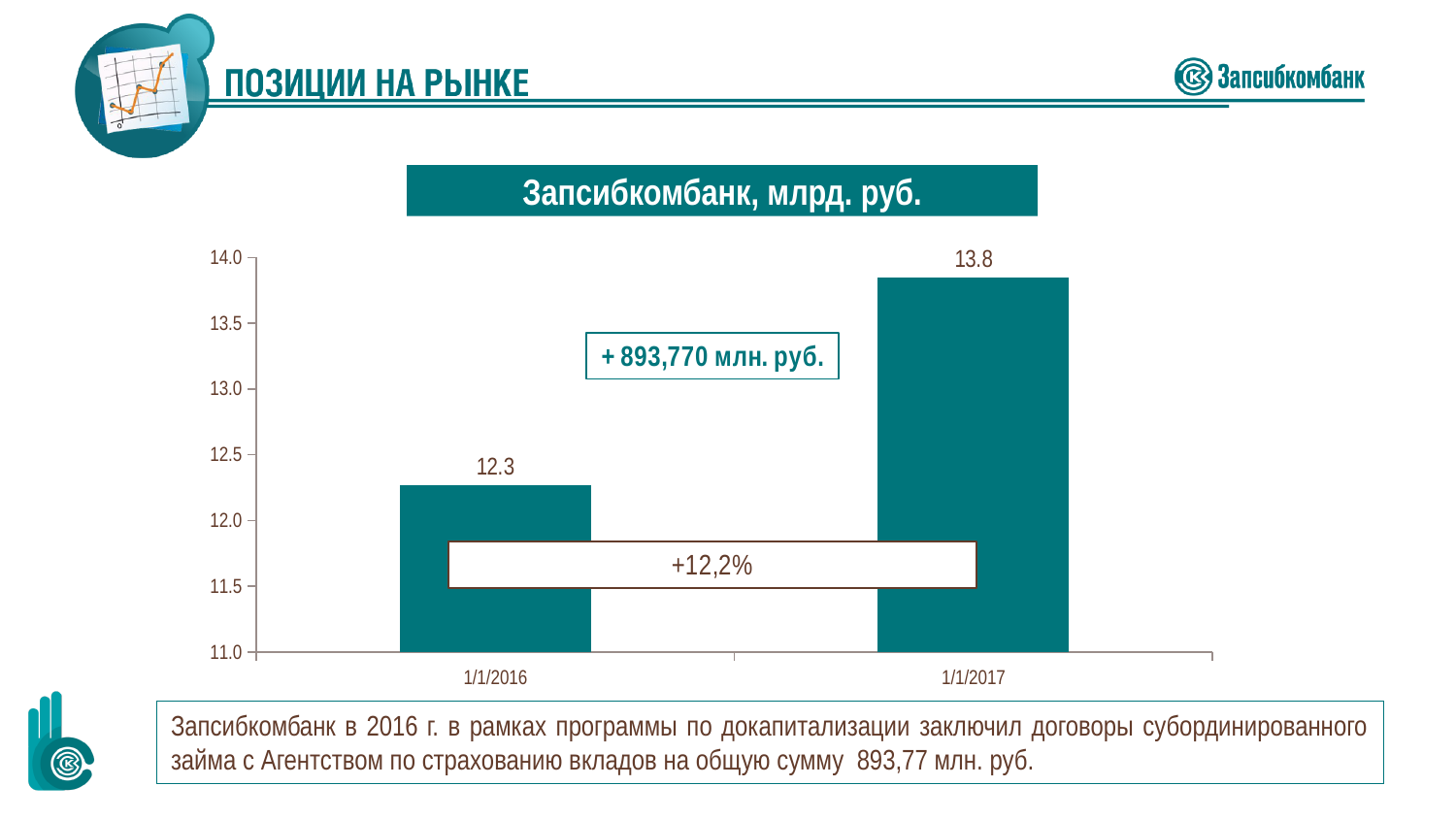
Do the values rise or fall from 1/1/2016 to 1/1/2017? rise Which category has the lowest value? 1/1/2016 Is the value for 1/1/2017 greater or less than 13.5? greater What is the value for 1/1/2016? 12.3 Which category has the highest value? 1/1/2017 What kind of chart is shown on the slide? bar chart How many categories are shown on the x axis? 2 What is the title of the chart? Запсибкомбанк, млрд. руб. What is the difference between the values for 1/1/2017 and 1/1/2016? 1.5 What is the value for 1/1/2017? 13.8 Is the value for 1/1/2016 greater or less than 12.5? less Which is larger, the value for 1/1/2016 or the value for 1/1/2017? 1/1/2017